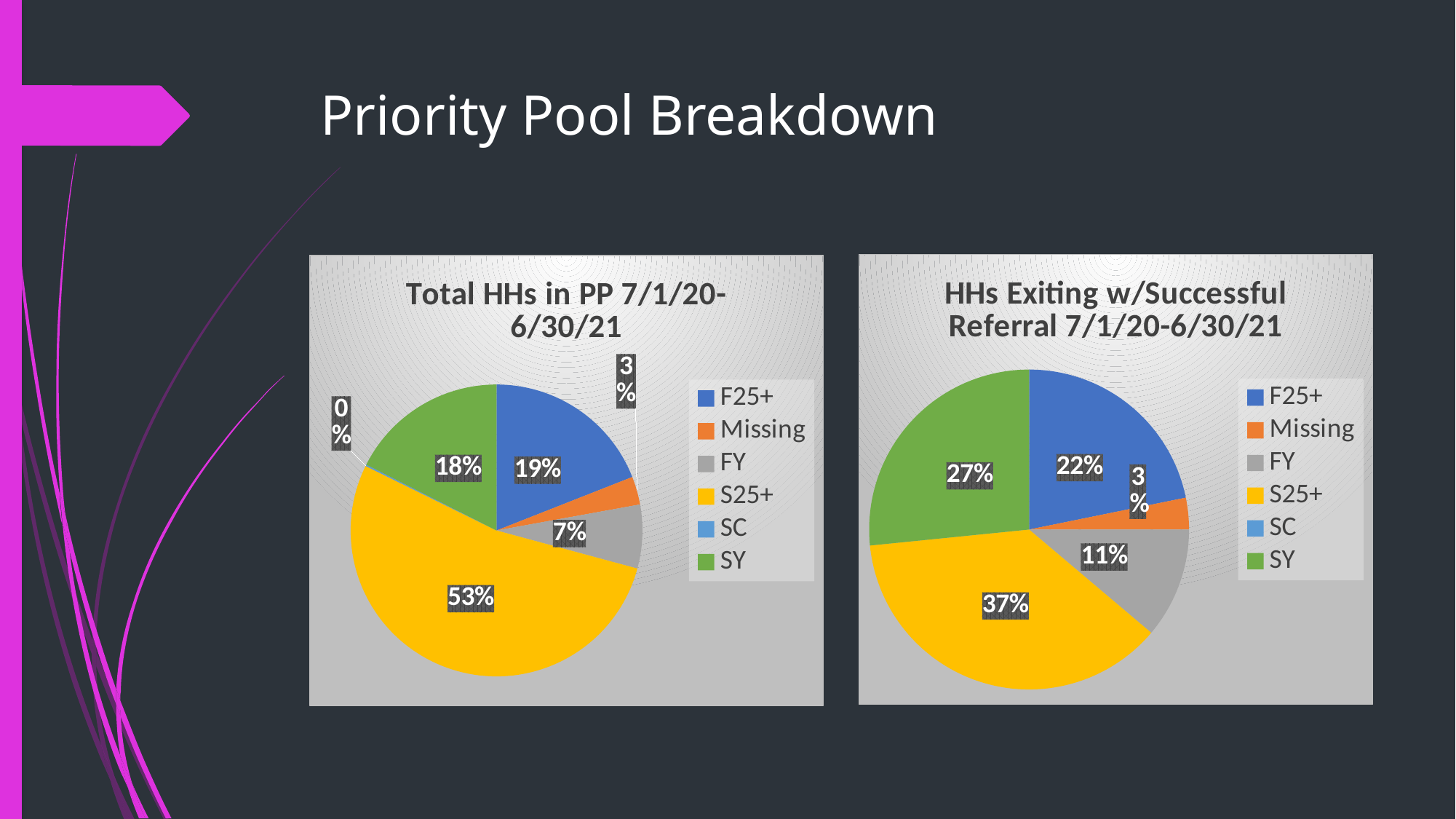
In the 'HHs Exiting w/Successful Referral 7/1/20-6/30/21' chart, what is the difference in percentage points between S25+ and SY? 10 In the 'HHs Exiting w/Successful Referral 7/1/20-6/30/21' chart, what percentage is labelled for SY? 27% In the 'HHs Exiting w/Successful Referral 7/1/20-6/30/21' chart, which category has the largest slice? S25+ What type of chart is used on the left side of the slide? Pie chart In the 'Total HHs in PP 7/1/20-6/30/21' chart, what share of the pie is S25+? 53% In the 'Total HHs in PP 7/1/20-6/30/21' chart, which is larger, the F25+ slice or the FY slice? F25+ In the 'Total HHs in PP 7/1/20-6/30/21' chart, what percentage is labelled for F25+? 19% In the 'Total HHs in PP 7/1/20-6/30/21' chart, which category has the largest slice? S25+ In the 'HHs Exiting w/Successful Referral 7/1/20-6/30/21' chart, what percentage is labelled for FY? 11% In the 'Total HHs in PP 7/1/20-6/30/21' chart, which category has the smallest slice? SC In the 'Total HHs in PP 7/1/20-6/30/21' chart, what percentage is labelled for SY? 18% In the 'HHs Exiting w/Successful Referral 7/1/20-6/30/21' chart, what percentage is labelled for S25+? 37%